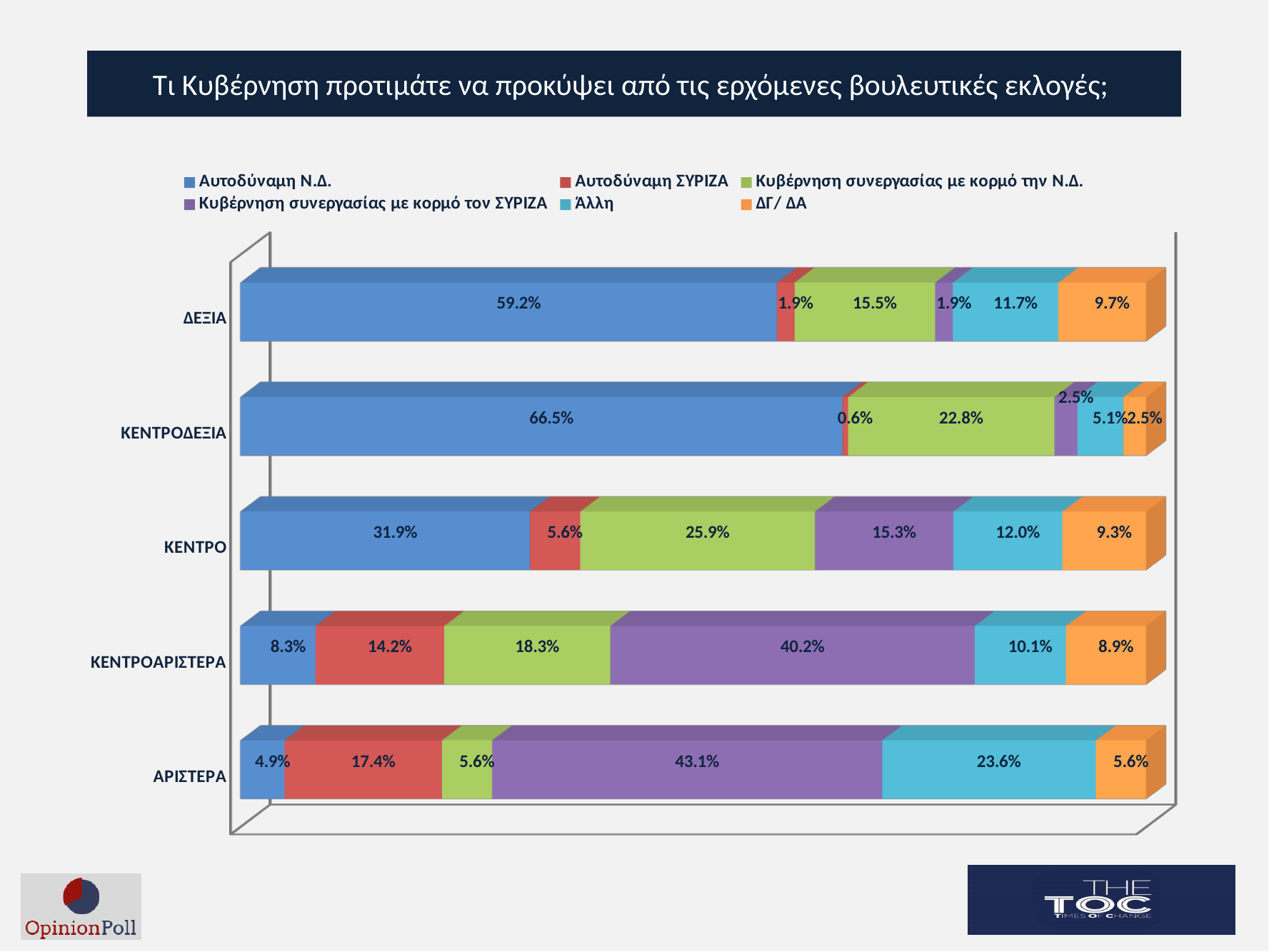
What kind of chart is shown on the slide? Stacked bar chart How many series does the legend list? 6 What is the value for Άλλη in the ΚΕΝΤΡΟΑΡΙΣΤΕΡΑ bar? 10.1% Which legend entry is shown in orange? ΔΓ/ ΔΑ Which category has the lowest value for Αυτοδύναμη ΣΥΡΙΖΑ? ΚΕΝΤΡΟΔΕΞΙΑ What is the value for ΔΓ/ ΔΑ in the ΚΕΝΤΡΟ bar? 9.3% What is the value for Αυτοδύναμη Ν.Δ. in the ΔΕΞΙΑ bar? 59.2% What is the difference between the Αυτοδύναμη Ν.Δ. values for ΚΕΝΤΡΟΔΕΞΙΑ and ΔΕΞΙΑ? 7.3 percentage points What is the value for Κυβέρνηση συνεργασίας με κορμό τον ΣΥΡΙΖΑ in the ΑΡΙΣΤΕΡΑ bar? 43.1% Which has the larger Άλλη value, ΑΡΙΣΤΕΡΑ or ΚΕΝΤΡΟ? ΑΡΙΣΤΕΡΑ Which category has the highest value for Αυτοδύναμη Ν.Δ.? ΚΕΝΤΡΟΔΕΞΙΑ How many categories (bars) are shown in the chart? 5